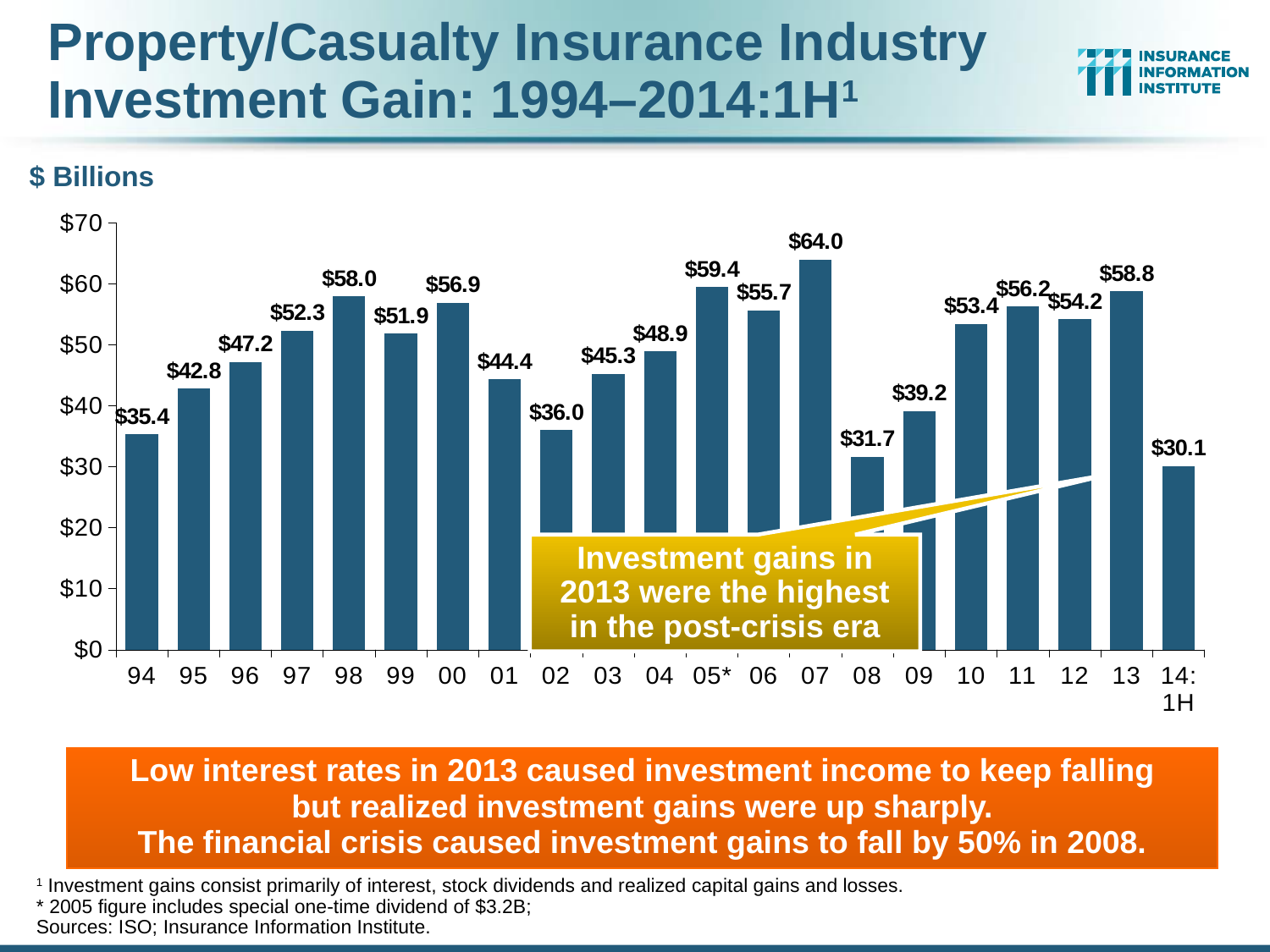
What is the investment gain value shown for 2008? $31.7 What is the investment gain value shown for 2007? $64.0 What is the difference between the investment gain in 2007 and in 2008? $32.3 What kind of chart is shown on the slide? bar chart What is the investment gain value shown for 14:1H? $30.1 Is the value for 2009 greater or less than $40? less What is the difference between the investment gain in 2013 and in 2012? $4.6 How many bars are plotted on the chart? 21 Which year has the highest investment gain on the chart? 07 Which bar has the lowest value on the chart? 14:1H Which year has a larger investment gain, 1998 or 2000? 98 What unit is indicated for the values on the chart? $ Billions